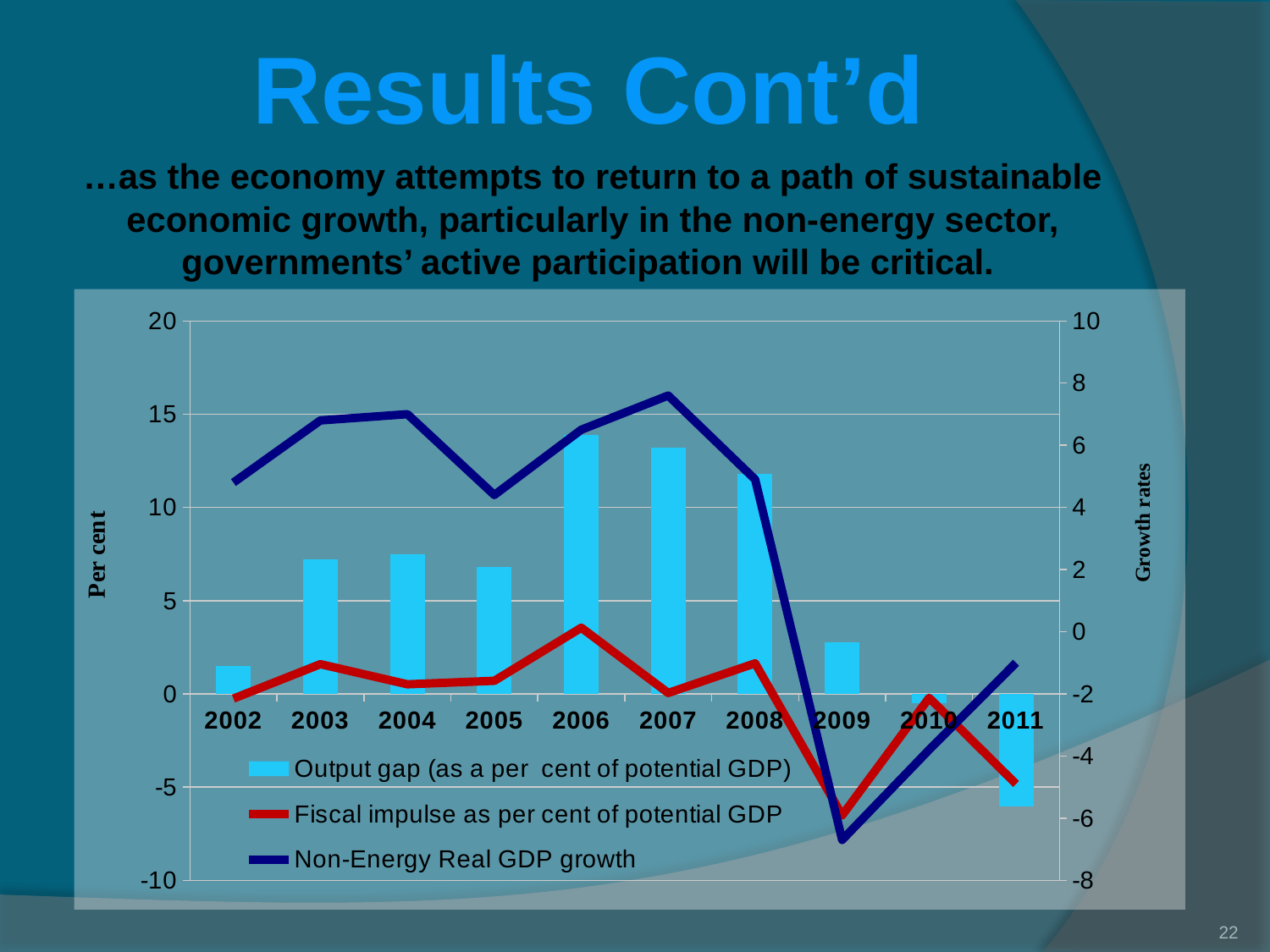
Is the Output gap value for 2006 greater or less than 10? greater Which is larger, the Output gap bar for 2007 or the Output gap bar for 2009? 2007 What kind of chart is shown on the slide? A combination bar and line chart Is the Non-Energy Real GDP growth value for 2009 greater or less than -4 on the right axis? less In which year is the Output gap bar the highest? 2006 In which year does the Non-Energy Real GDP growth line reach its lowest point? 2009 How many series does the legend list? 3 Is the Output gap value for 2011 greater or less than 0? less In which year does the Non-Energy Real GDP growth line reach its highest point? 2007 How many years are shown on the x axis? 10 Does the Non-Energy Real GDP growth line rise or fall from 2008 to 2009? fall In which year is the Output gap bar the lowest? 2011